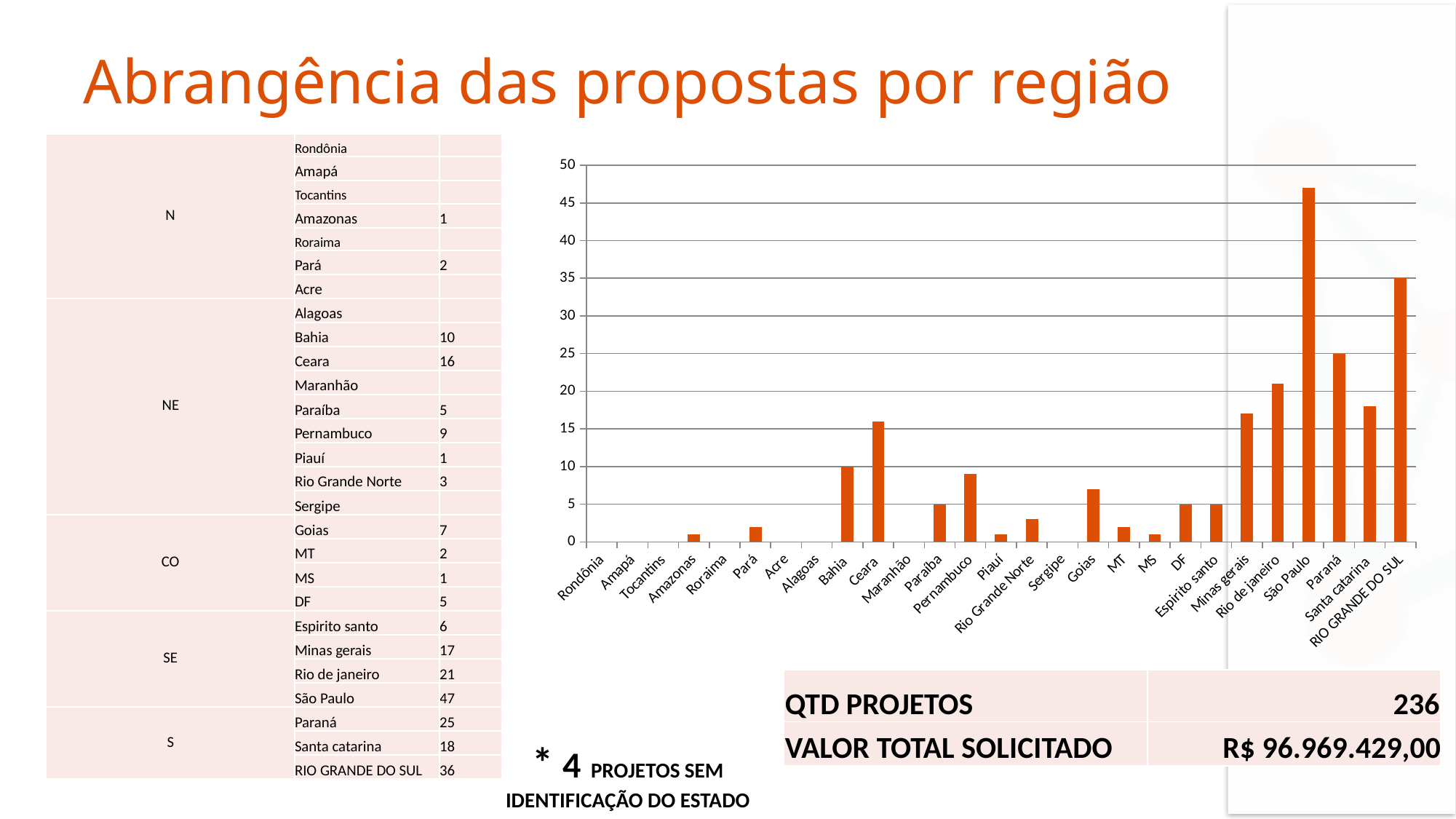
What kind of chart is shown on the slide? bar chart Which state has the highest bar in the chart? São Paulo What is the difference between the values for Bahia and Paraíba? 5 Is the value for São Paulo greater or less than 45? greater What is the value for Bahia in the chart? 10 How many states are listed along the x axis of the chart? 27 Is the value for Santa catarina greater or less than 20? less What is the value for Paraná in the chart? 25 What is the value for Paraíba in the chart? 5 Is the value for Ceara greater or less than 15? greater Which is larger, the value for Rio de janeiro or the value for Minas gerais? Rio de janeiro Which is larger, the value for Paraná or the value for Santa catarina? Paraná